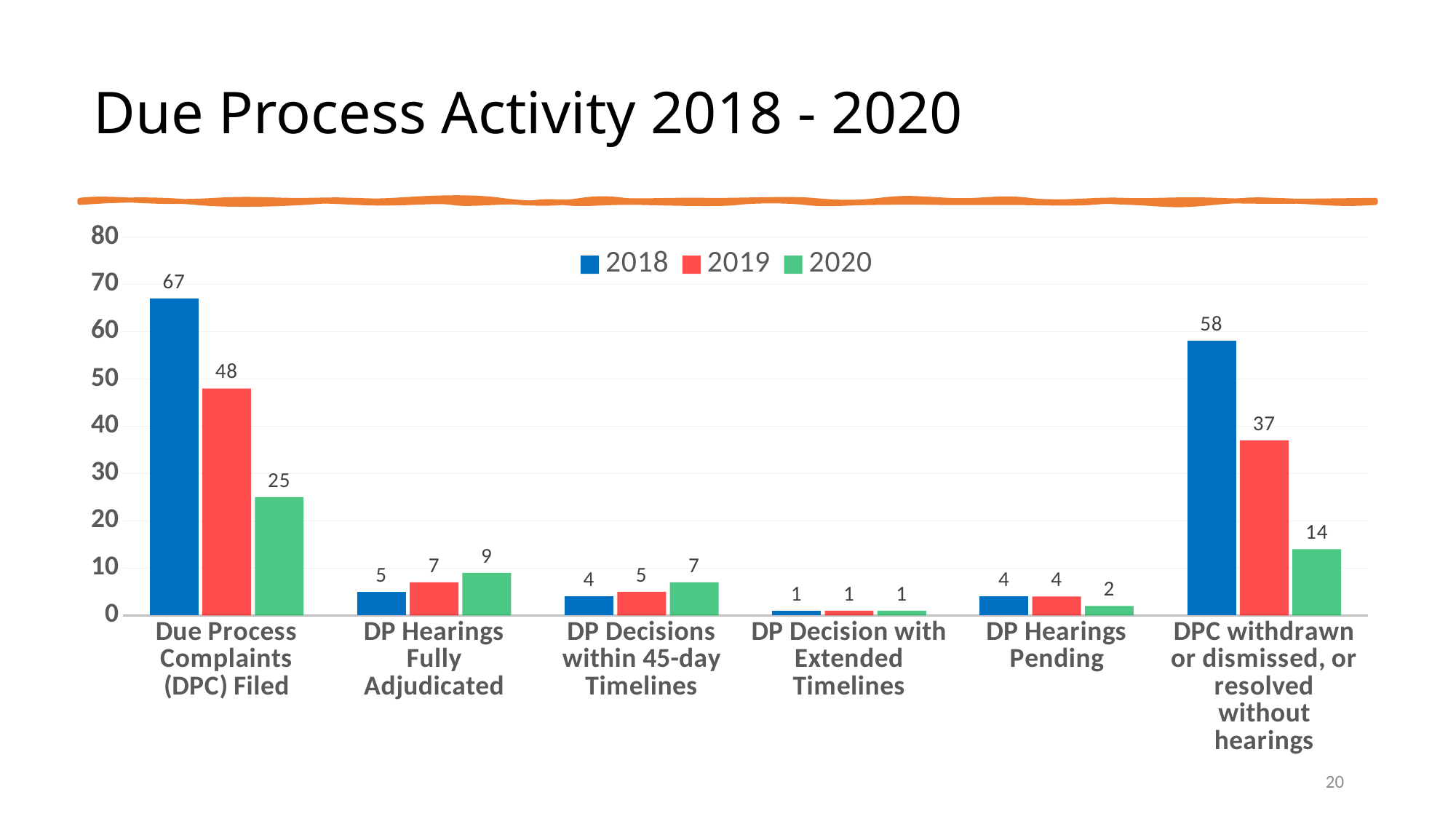
How many series does the legend list? 3 Which is larger: the 2019 value for DPC withdrawn or dismissed, or resolved without hearings, or the 2019 value for Due Process Complaints (DPC) Filed? Due Process Complaints (DPC) Filed What was the number of Due Process Complaints (DPC) Filed in 2018? 67 Is the 2018 value for DPC withdrawn or dismissed, or resolved without hearings greater or less than 50? greater Which category has the lowest value for 2018? DP Decision with Extended Timelines How many categories are shown on the x axis? 6 How many DP Hearings were Fully Adjudicated in 2019? 7 What kind of chart is shown on the slide? Bar chart Do the values for Due Process Complaints (DPC) Filed rise or fall from 2018 to 2020? Fall What is the difference between the 2018 and 2020 values for Due Process Complaints (DPC) Filed? 42 What was the 2020 value for DPC withdrawn or dismissed, or resolved without hearings? 14 Which category has the highest value for 2019? Due Process Complaints (DPC) Filed